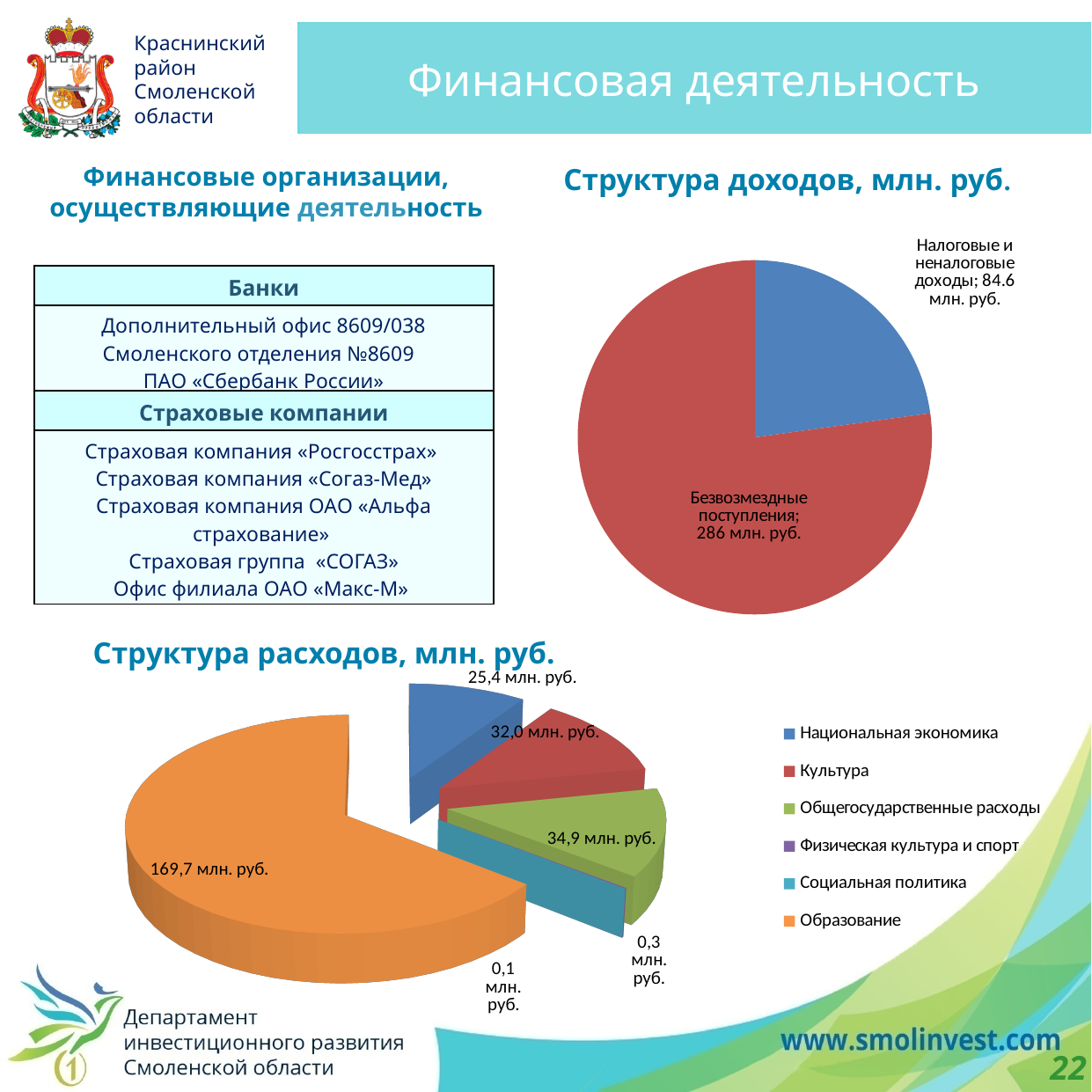
On the chart titled «Структура расходов, млн. руб.», what is the value for «Культура»? 32,0 млн. руб. On the chart titled «Структура расходов, млн. руб.», how many categories does the legend list? 6 On the chart titled «Структура доходов, млн. руб.», what is the value for «Налоговые и неналоговые доходы»? 84.6 млн. руб. On the chart titled «Структура доходов, млн. руб.», how many slices does the pie have? 2 On the chart titled «Структура расходов, млн. руб.», what is the value for «Образование»? 169,7 млн. руб. On the chart titled «Структура расходов, млн. руб.», which category has the highest value? Образование What kind of chart is «Структура расходов, млн. руб.»? Pie chart On the chart titled «Структура доходов, млн. руб.», which category has the larger value? Безвозмездные поступления On the chart titled «Структура доходов, млн. руб.», what is the value for «Безвозмездные поступления»? 286 млн. руб. On the chart titled «Структура доходов, млн. руб.», how much larger is «Безвозмездные поступления» than «Налоговые и неналоговые доходы»? 201.4 млн. руб. On the chart titled «Структура расходов, млн. руб.», what is the value for «Национальная экономика»? 25,4 млн. руб. On the chart titled «Структура расходов, млн. руб.», which is larger: «Общегосударственные расходы» or «Культура»? Общегосударственные расходы